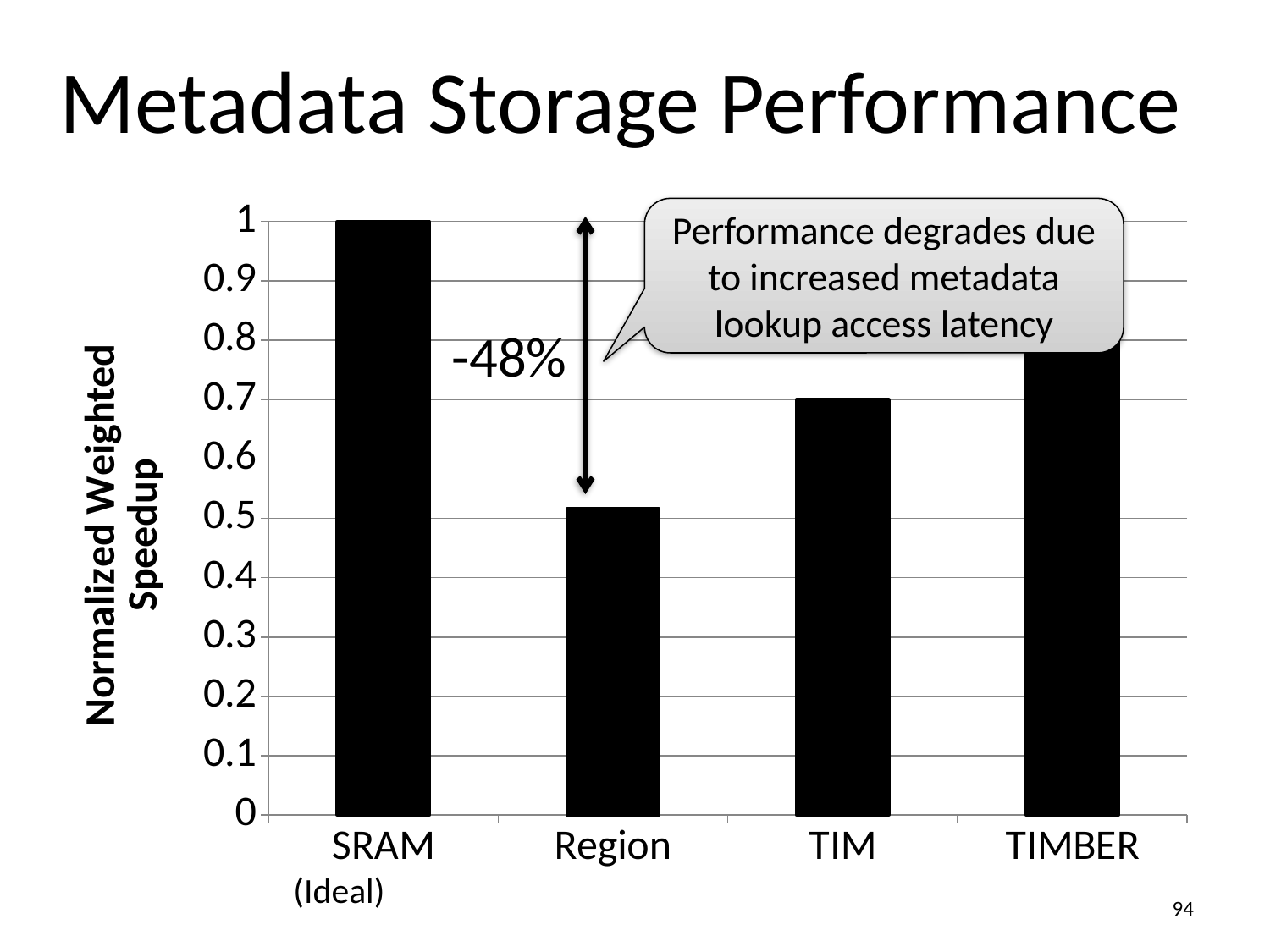
Which category has the lowest normalized weighted speedup? Region Is the value for TIMBER greater or less than 0.7? greater What is the title of the y axis? Normalized Weighted Speedup Is the value for Region greater or less than 0.6? less How many categories are plotted on the x axis? 4 What is the normalized weighted speedup for SRAM (Ideal)? 1 Which category has the highest normalized weighted speedup? SRAM (Ideal) What kind of chart is shown on the slide? bar chart What percentage change is annotated between the SRAM and Region bars? -48% Which has a higher normalized weighted speedup, TIM or Region? TIM Which has a higher normalized weighted speedup, TIMBER or TIM? TIMBER Is the value for TIM greater or less than 0.6? greater